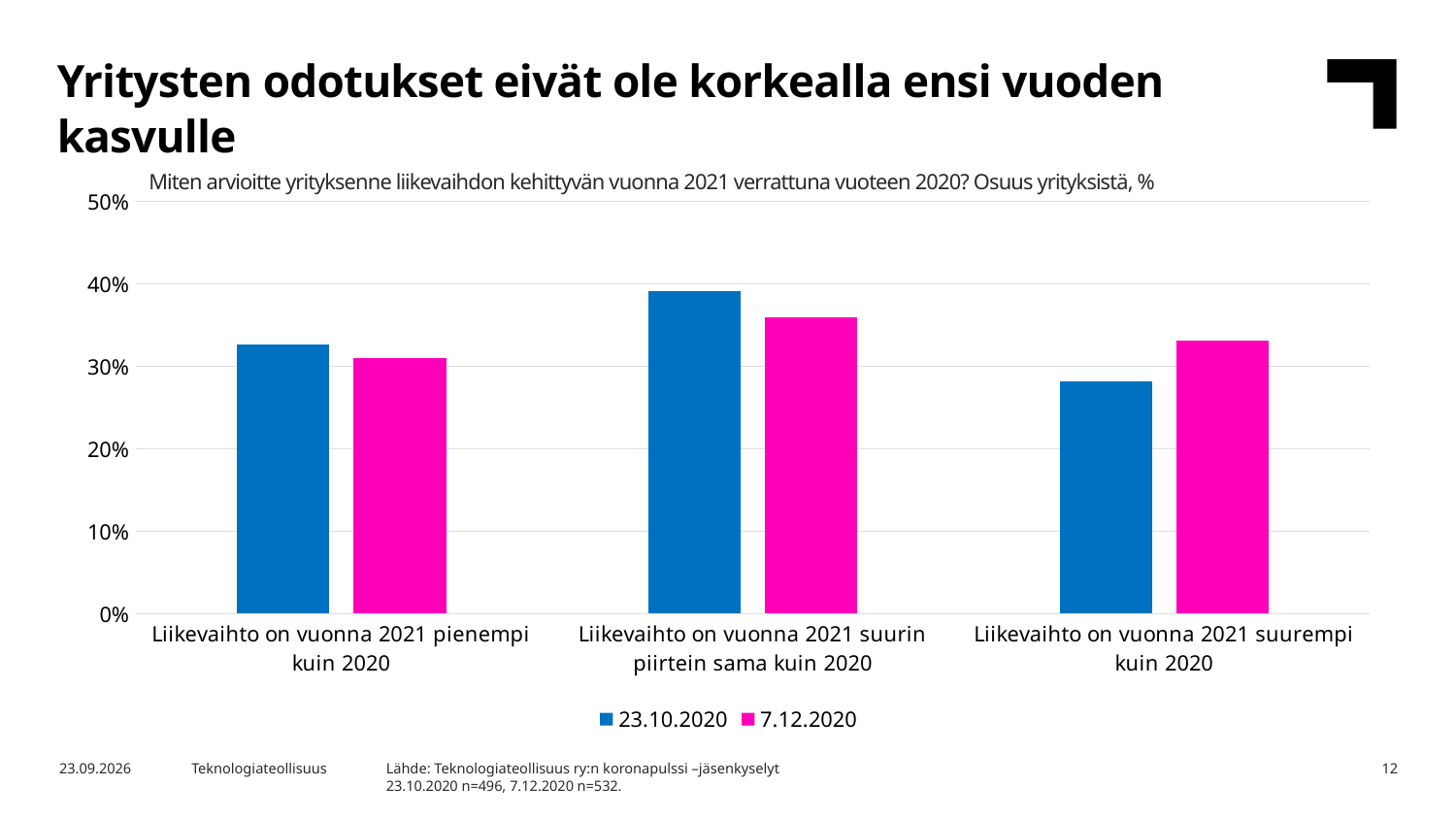
Which category has the lowest value for the 23.10.2020 series? Liikevaihto on vuonna 2021 suurempi kuin 2020 Which category has the highest value for the 23.10.2020 series? Liikevaihto on vuonna 2021 suurin piirtein sama kuin 2020 How many series does the chart legend list? 2 What kind of chart is shown on the slide? bar chart Which category has the highest value for the 7.12.2020 series? Liikevaihto on vuonna 2021 suurin piirtein sama kuin 2020 Is the 23.10.2020 value for 'Liikevaihto on vuonna 2021 suurempi kuin 2020' greater or less than 30%? less What are the two series names listed in the chart legend? 23.10.2020 and 7.12.2020 For the category 'Liikevaihto on vuonna 2021 suurin piirtein sama kuin 2020', which series has the larger value, 23.10.2020 or 7.12.2020? 23.10.2020 Is the 7.12.2020 value for 'Liikevaihto on vuonna 2021 suurempi kuin 2020' greater or less than 30%? greater Is the 23.10.2020 value for 'Liikevaihto on vuonna 2021 suurin piirtein sama kuin 2020' greater or less than 40%? less How many categories are shown on the x axis of the chart? 3 For the category 'Liikevaihto on vuonna 2021 suurempi kuin 2020', which series has the larger value, 23.10.2020 or 7.12.2020? 7.12.2020